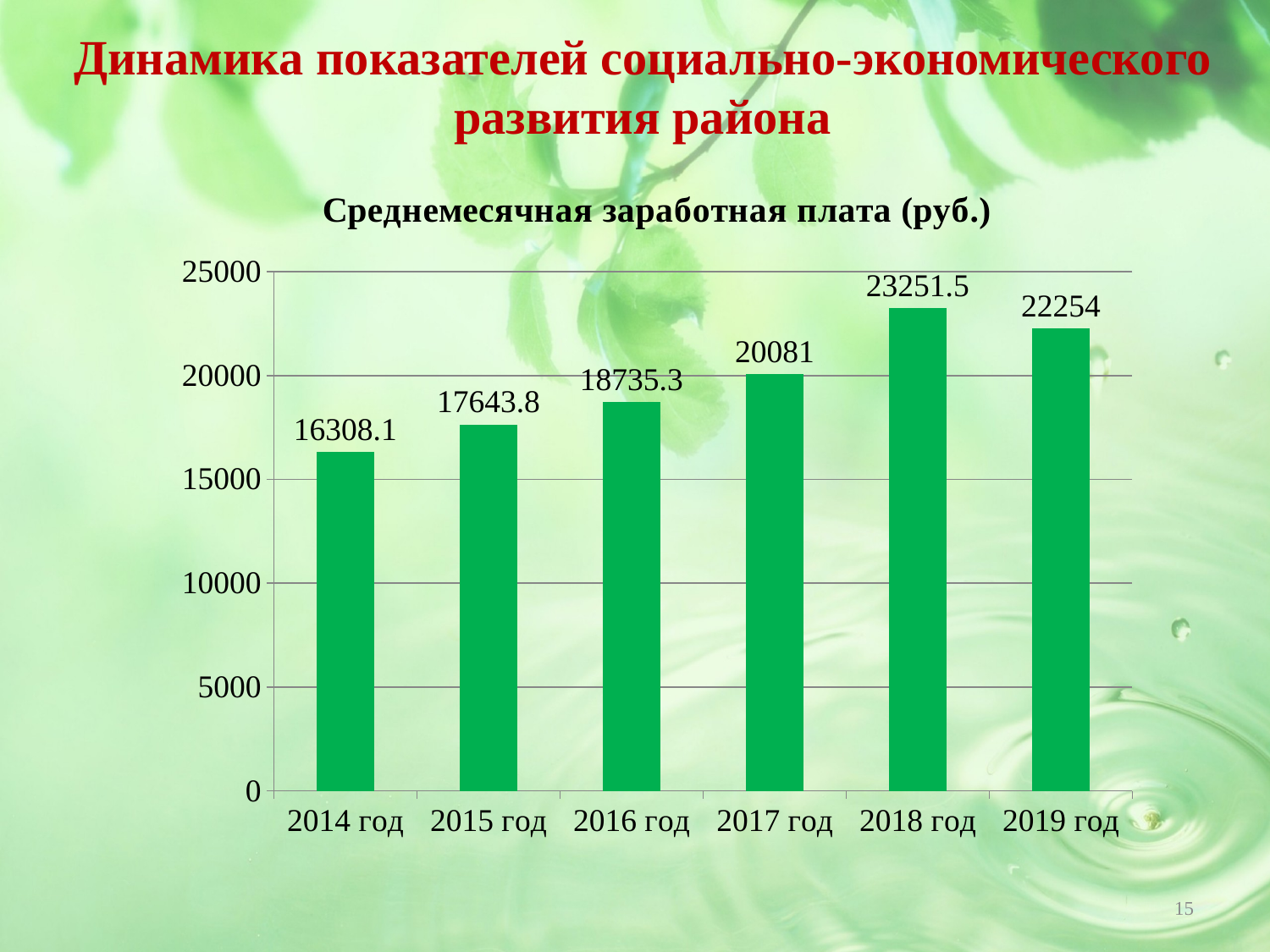
What is the average monthly salary value shown for 2014 год? 16308.1 Which year has the lowest average monthly salary? 2014 год What is the difference between the values for 2015 год and 2014 год? 1335.7 What is the difference between the values for 2018 год and 2019 год? 997.5 How many years are shown on the x axis? 6 What is the value shown for 2019 год? 22254 What kind of chart is shown on the slide? bar chart Is the value for 2017 год greater or less than 20000? greater Which is larger, the value for 2017 год or the value for 2016 год? 2017 год What is the title of the chart? Среднемесячная заработная плата (руб.) Which year has the highest average monthly salary? 2018 год What value is labelled on the bar for 2018 год? 23251.5